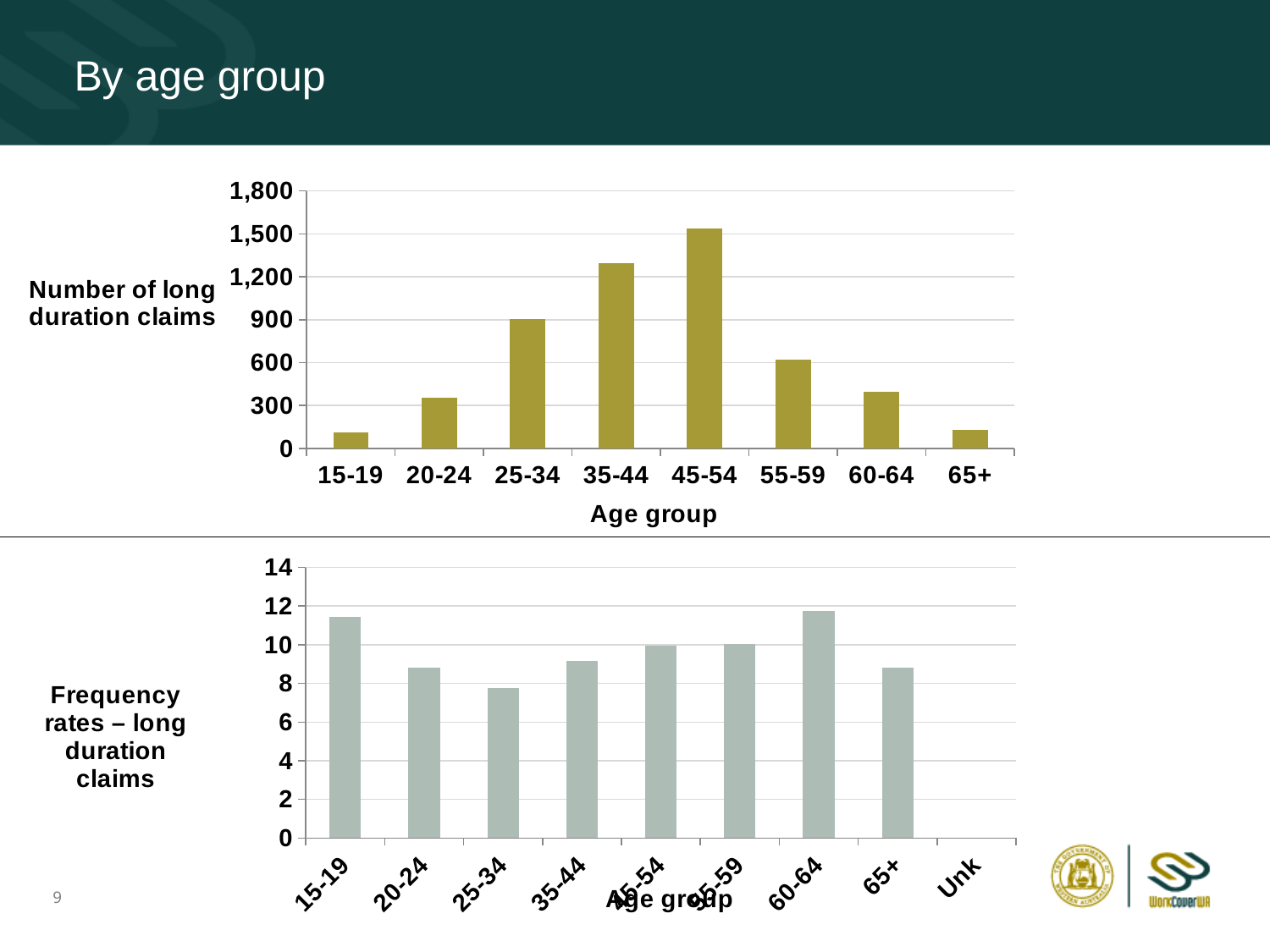
In the top chart (Number of long duration claims), is the value for the 20-24 age group greater or less than 300? greater In the top chart (Number of long duration claims), is the value for the 65+ age group greater or less than 300? less How many age group categories are shown on the x axis of the top chart (Number of long duration claims)? 8 In the bottom chart (Frequency rates – long duration claims), is the value for the 25-34 age group greater or less than 8? less In the top chart (Number of long duration claims), which age group has the highest number of long duration claims? 45-54 What kind of chart is the top chart (Number of long duration claims)? Bar chart In the top chart (Number of long duration claims), which has more long duration claims, the 35-44 age group or the 55-59 age group? 35-44 How many categories are shown on the x axis of the bottom chart (Frequency rates – long duration claims)? 9 In the bottom chart (Frequency rates – long duration claims), which age group has the highest frequency rate? 60-64